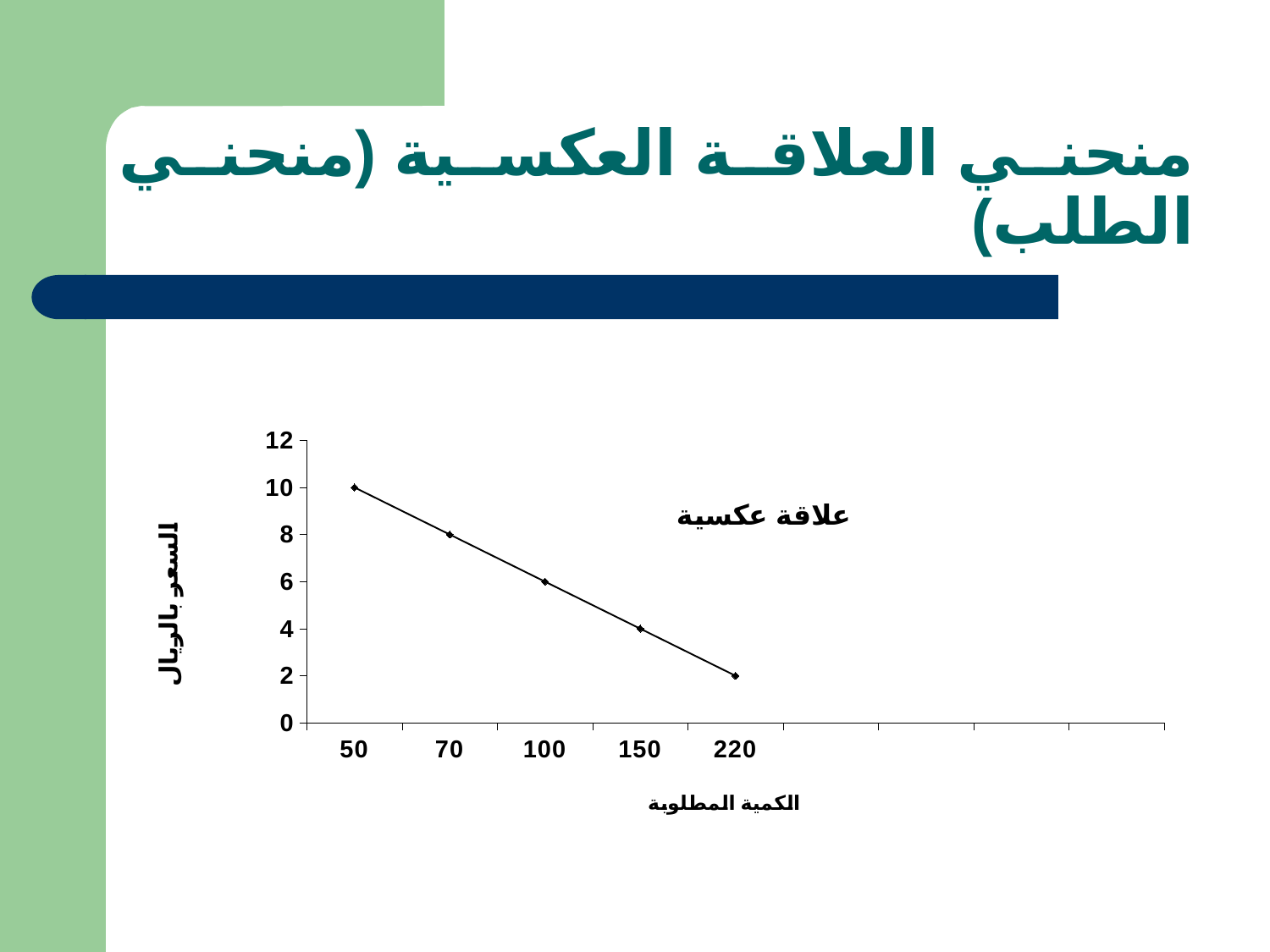
At which quantity demanded is the price highest? 50 Which has a higher price: quantity 70 or quantity 150? 70 What is the price when the quantity demanded is 100? 6 What is the price when the quantity demanded is 220? 2 What is the difference between the price at quantity 50 and the price at quantity 150? 6 How many data points are plotted on the line? 5 What kind of chart is shown on the slide? line chart Does the price rise or fall as the quantity demanded increases along the x axis? fall What is the price (السعر بالريال) when the quantity demanded is 50? 10 At which quantity demanded is the price lowest? 220 What is the label of the x axis? الكمية المطلوبة What is the price when the quantity demanded is 70? 8